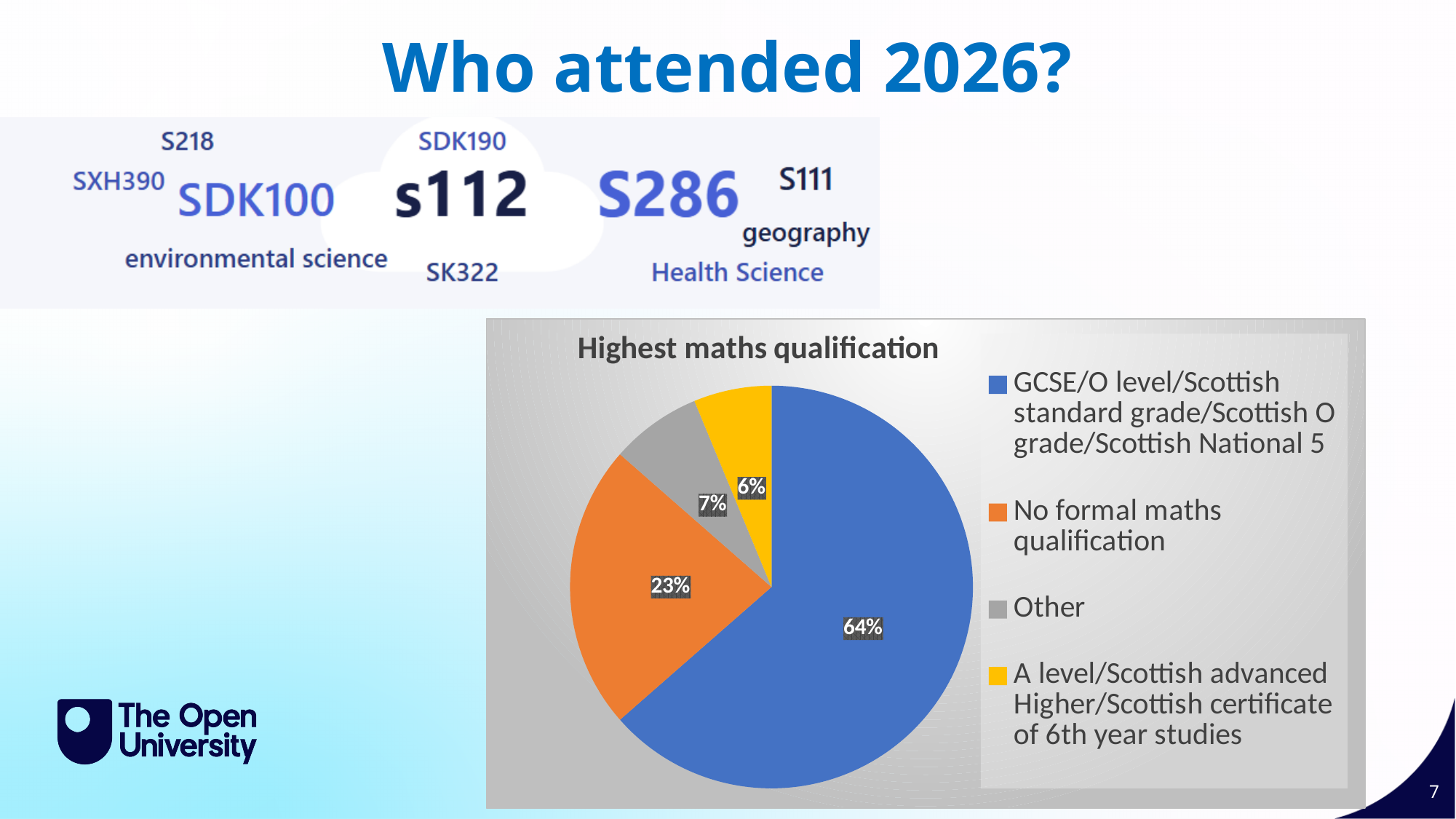
What share of the pie is 'A level/Scottish advanced Higher/Scottish certificate of 6th year studies'? 6% What share of the pie is 'No formal maths qualification'? 23% How many categories does the pie chart show? 4 What is the title of the pie chart? Highest maths qualification What is the difference in percentage points between the GCSE/O level slice and the 'No formal maths qualification' slice? 41 Which is larger: the 'Other' slice or the 'No formal maths qualification' slice? No formal maths qualification What type of chart is used to show the highest maths qualification? pie chart What share of the pie is 'Other'? 7% What colour is the 'Other' slice in the pie chart? grey What share of the pie is 'GCSE/O level/Scottish standard grade/Scottish O grade/Scottish National 5'? 64% Which category has the largest slice of the pie? GCSE/O level/Scottish standard grade/Scottish O grade/Scottish National 5 Which category has the smallest slice of the pie? A level/Scottish advanced Higher/Scottish certificate of 6th year studies